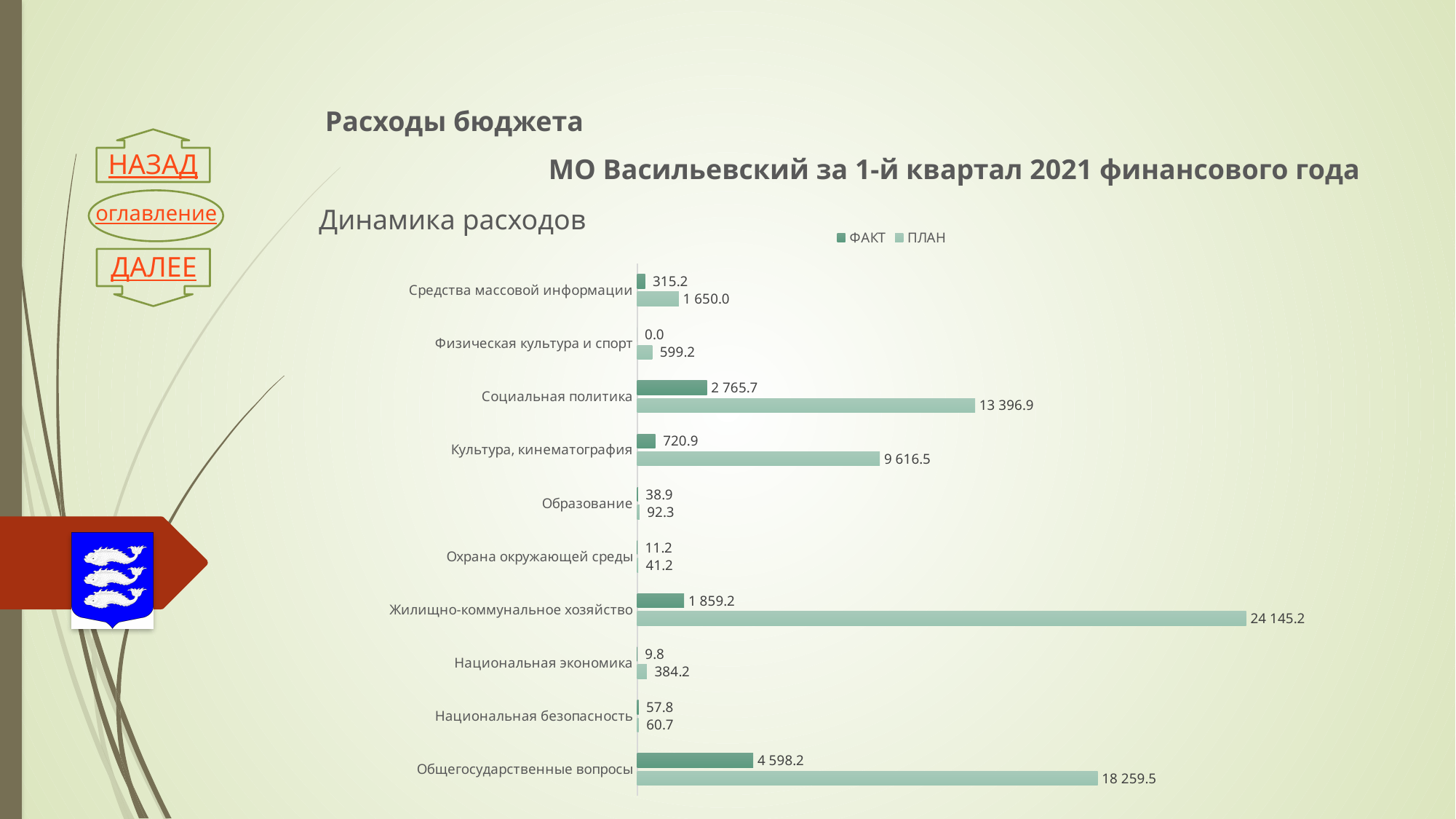
What kind of chart is shown on the slide? Bar chart How many series does the legend list? 2 What is the ПЛАН value for Национальная экономика? 384.2 Which category has the highest ФАКТ value? Общегосударственные вопросы How many categories are shown in the chart? 10 What is the ФАКТ value for Общегосударственные вопросы? 4 598.2 What is the ПЛАН value for Социальная политика? 13 396.9 Which category has the lowest ФАКТ value? Физическая культура и спорт Which category has the highest ПЛАН value? Жилищно-коммунальное хозяйство What is the difference between the ПЛАН and ФАКТ values for Культура, кинематография? 8 895.6 Which has the larger ФАКТ value: Социальная политика or Жилищно-коммунальное хозяйство? Социальная политика Which category has the lowest ПЛАН value? Охрана окружающей среды